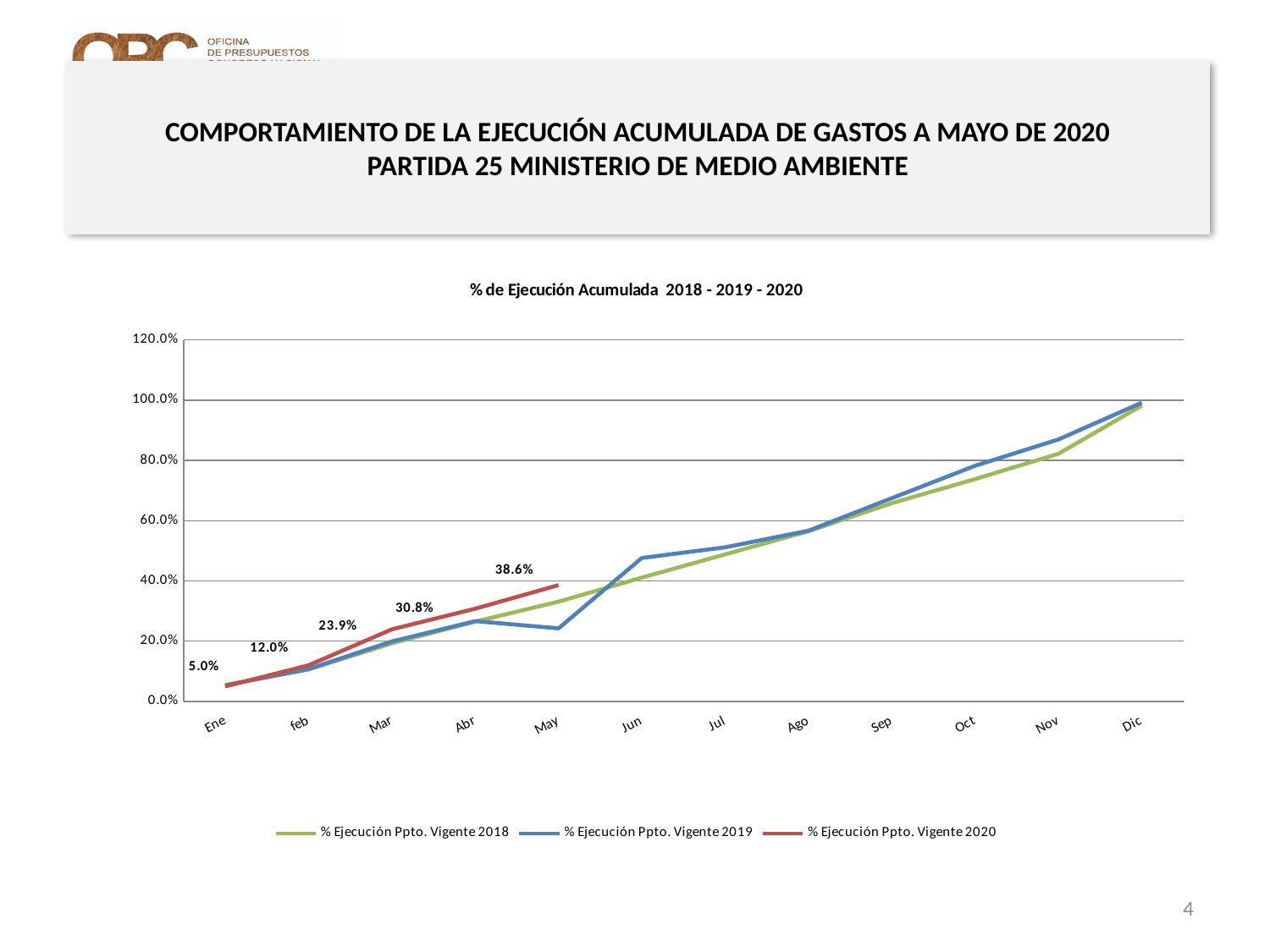
In which month is the % Ejecución Ppto. Vigente 2020 series highest? May How many series does the legend list? 3 Is the value for % Ejecución Ppto. Vigente 2019 in Jun greater or less than 40.0%? greater What is the value of % Ejecución Ppto. Vigente 2020 in Mar? 23.9% What is the difference between the 2020 values for feb and Ene? 7.0% What is the value of % Ejecución Ppto. Vigente 2020 in Abr? 30.8% How many months are shown on the x axis? 12 In which month is the % Ejecución Ppto. Vigente 2020 series lowest? Ene What kind of chart is shown on the slide? Line chart What is the value of % Ejecución Ppto. Vigente 2020 in Ene? 5.0% What is the value of % Ejecución Ppto. Vigente 2020 in May? 38.6% What is the difference between the 2020 values for May and Abr? 7.8%